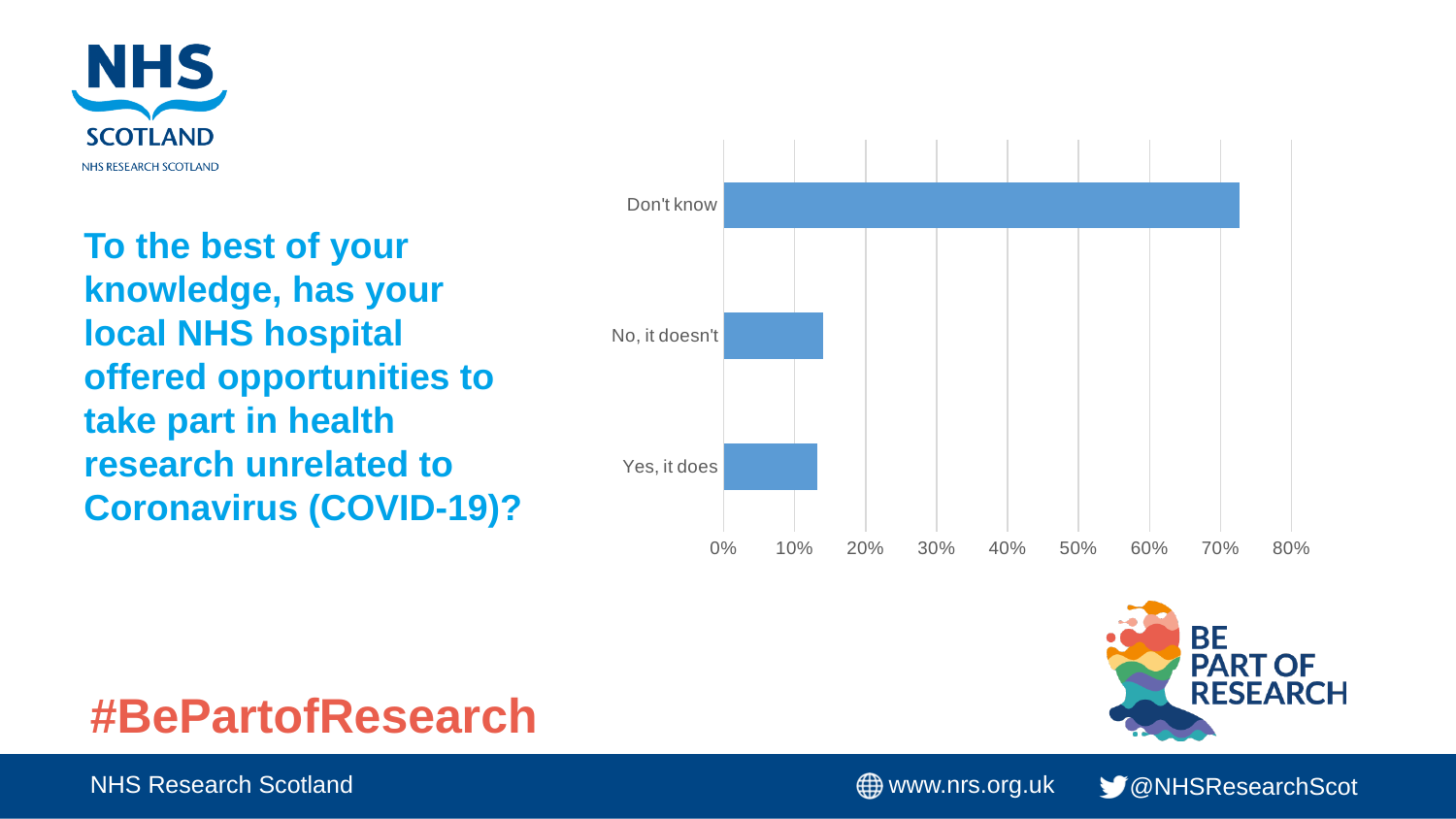
Is the value for "No, it doesn't" greater or less than 10%? greater What is the highest value shown on the chart's horizontal axis? 80% Is the value for "Don't know" greater or less than 60%? greater Is the value for "Yes, it does" greater or less than 20%? less What kind of chart is shown on the slide? bar chart Which is larger, the value for "Don't know" or the value for "Yes, it does"? Don't know Which response category has the highest value in the chart? Don't know What colour are the bars in the chart? blue Which is larger, the value for "Don't know" or the value for "No, it doesn't"? Don't know How many response categories are shown in the chart? 3